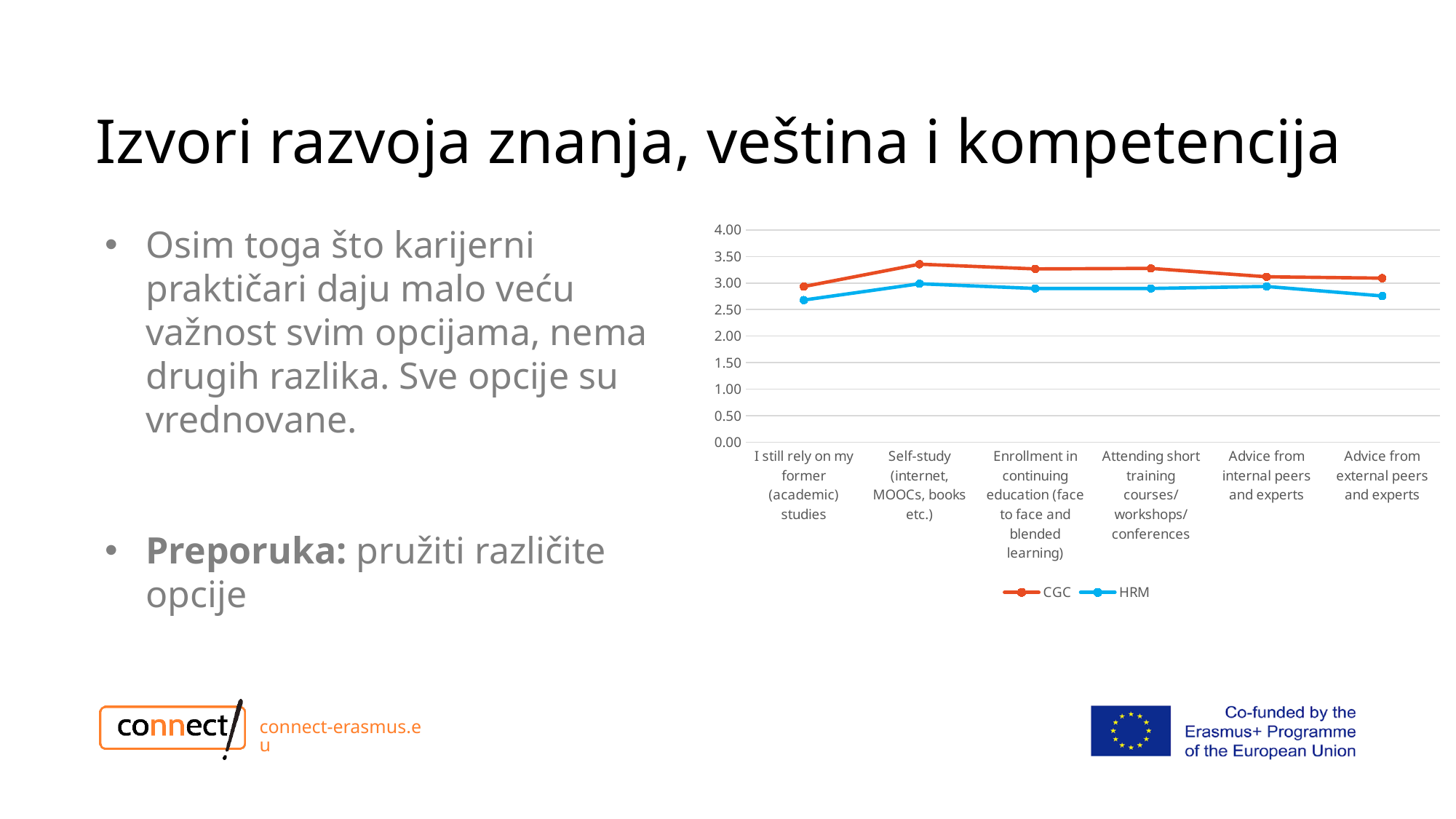
Is the HRM value for I still rely on my former (academic) studies greater or less than 3.00? less What kind of chart is shown on the slide? line chart Which category has the highest CGC value? Self-study (internet, MOOCs, books etc.) Which series is plotted with the blue line? HRM How many categories are shown on the x axis of the chart? 6 Is the CGC value for Self-study (internet, MOOCs, books etc.) greater or less than 3.00? greater Which series lies above the other across all categories in the chart? CGC For Self-study (internet, MOOCs, books etc.), which series has the larger value, CGC or HRM? CGC Is the HRM value for Advice from external peers and experts greater or less than 3.00? less How many series does the chart legend list? 2 Which category has the lowest CGC value? I still rely on my former (academic) studies